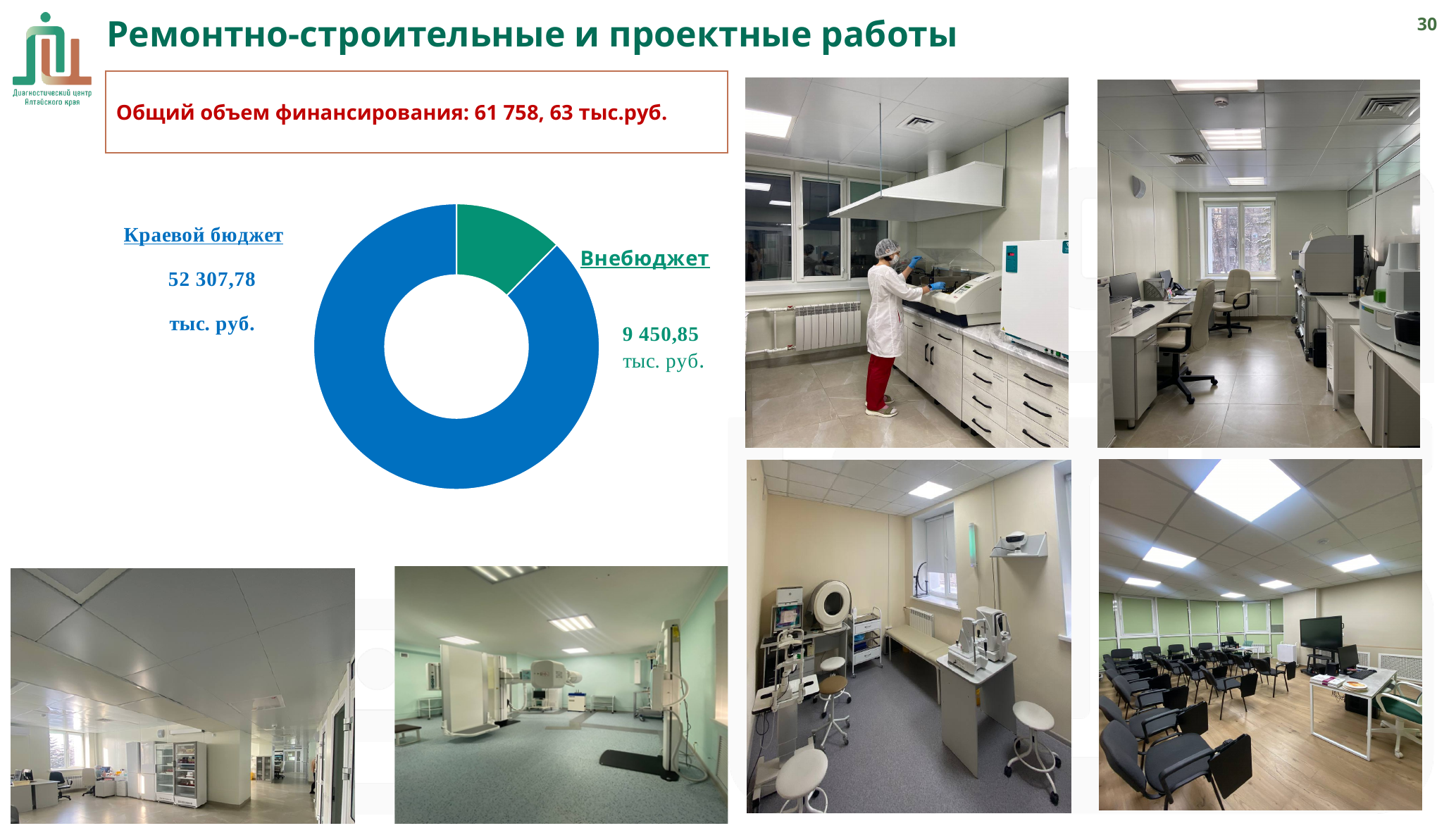
What is the value for Краевой бюджет in the donut chart? 52 307,78 тыс. руб. Which category has the smallest slice in the donut chart? Внебюджет What colour is the Краевой бюджет slice in the donut chart? Blue What colour is the Внебюджет slice in the donut chart? Green What is the value for Внебюджет in the donut chart? 9 450,85 тыс. руб. Which category has the largest slice in the donut chart? Краевой бюджет What kind of chart is shown on the slide? Donut (pie) chart How many categories does the donut chart show? 2 What is the difference between the Краевой бюджет and Внебюджет values in the donut chart? 42 856,93 тыс. руб. What is the total funding amount stated on the slide for the two categories in the chart? 61 758, 63 тыс.руб. Which is larger in the donut chart: Краевой бюджет or Внебюджет? Краевой бюджет